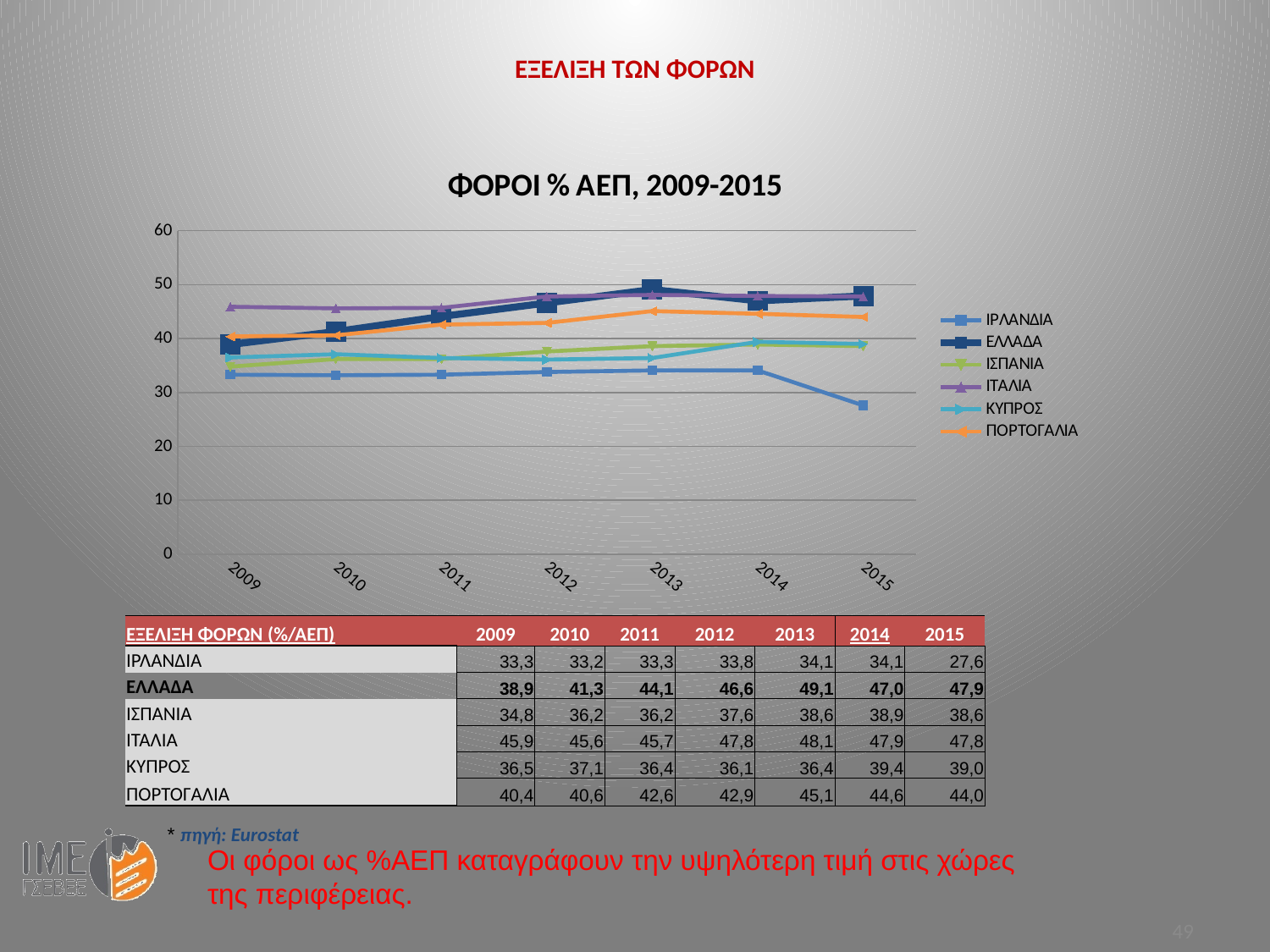
Which country has the highest value in 2009? ΙΤΑΛΙΑ Which country has the lowest value in 2015? ΙΡΛΑΝΔΙΑ What is the value for ΕΛΛΑΔΑ in 2013? 49,1 What kind of chart is shown on the slide? line chart Does the value for ΕΛΛΑΔΑ rise or fall from 2009 to 2013? rise What is the title of the chart? ΦΟΡΟΙ % ΑΕΠ, 2009-2015 By how much did the value for ΕΛΛΑΔΑ change from 2009 to 2015? 9,0 How many years are plotted along the x axis of the chart? 7 Which is larger in 2012, the value for ΠΟΡΤΟΓΑΛΙΑ or the value for ΙΣΠΑΝΙΑ? ΠΟΡΤΟΓΑΛΙΑ How many series does the legend of the chart list? 6 Is the value for ΙΤΑΛΙΑ in 2013 greater or less than 40? greater What is the value for ΙΡΛΑΝΔΙΑ in 2015? 27,6